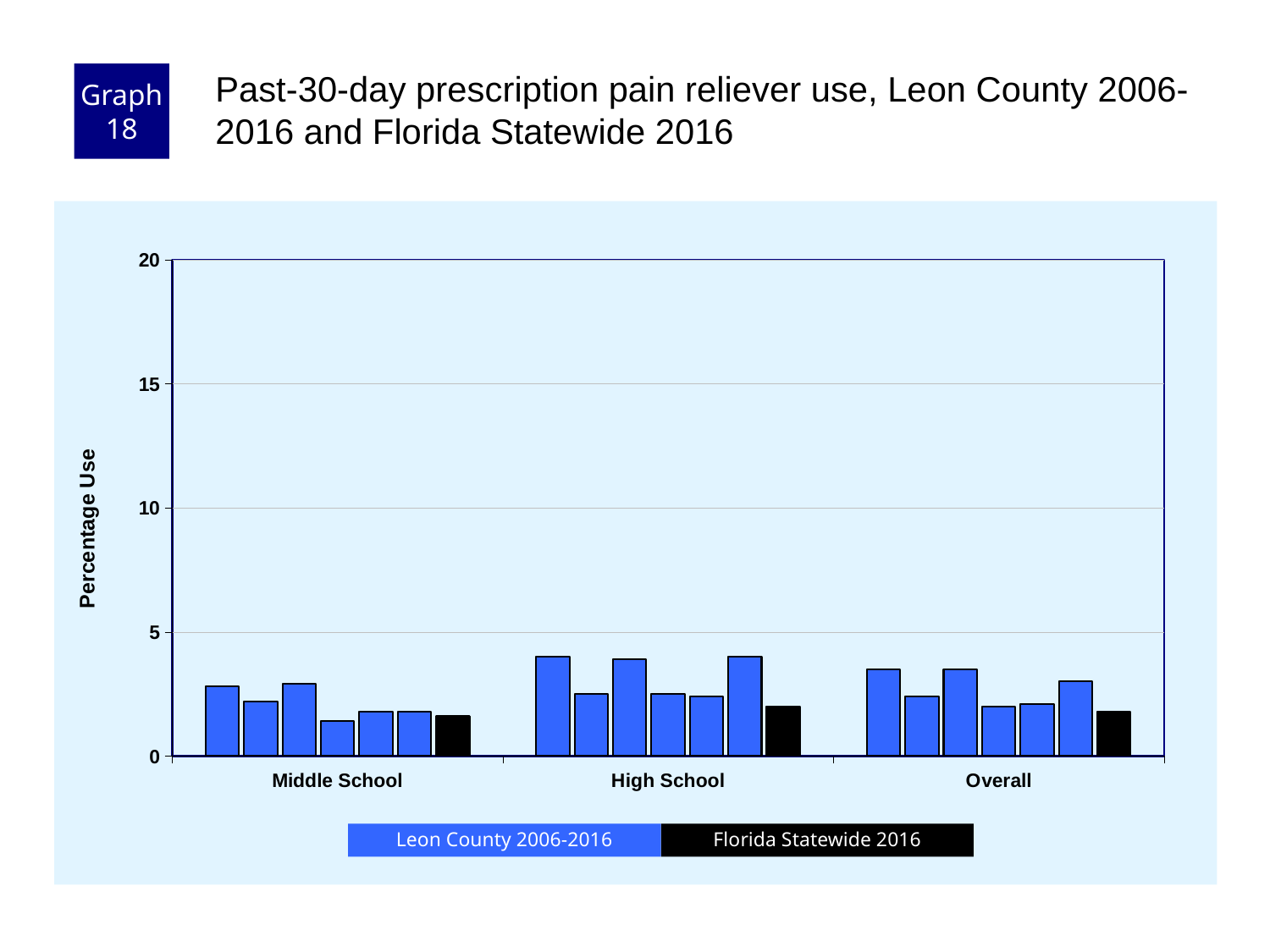
Is the tallest Leon County 2006-2016 bar in the High School group greater or less than 5? less Is the value for Florida Statewide 2016 in the High School group greater or less than 5? less How many series does the legend list? 2 Is the value for Florida Statewide 2016 in the Middle School group greater or less than 5? less In the High School group, which is larger: the first Leon County 2006-2016 bar or the Florida Statewide 2016 bar? the first Leon County 2006-2016 bar In the Middle School group, which is larger: the first Leon County 2006-2016 bar or the Florida Statewide 2016 bar? the first Leon County 2006-2016 bar What kind of chart is shown on the slide? bar chart What is the label of the y axis? Percentage Use Which series is shown in black in the legend? Florida Statewide 2016 Which category group contains the tallest bar on the chart? High School How many categories are shown on the x axis? 3